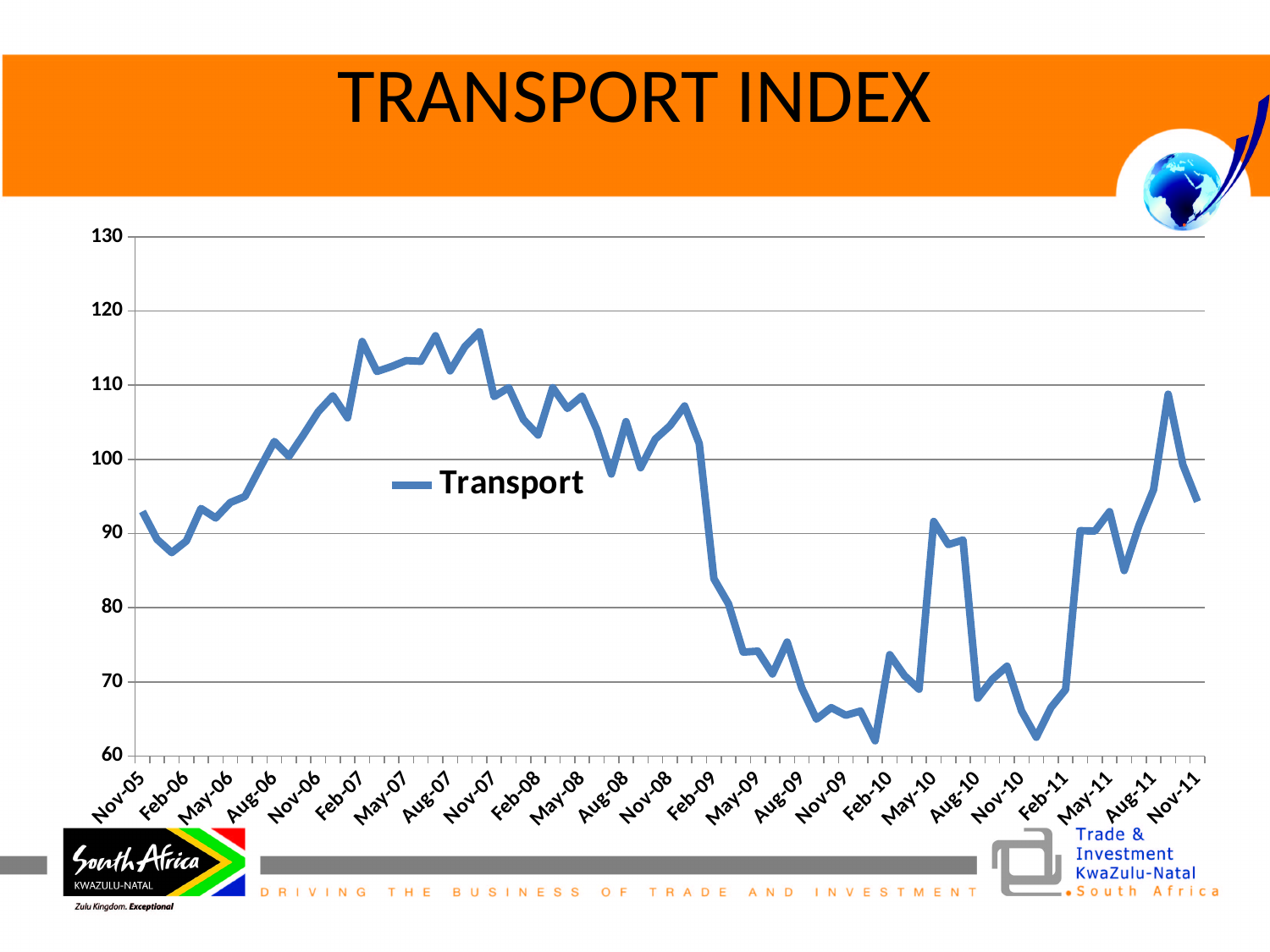
Does the Transport index generally rise or fall between Feb-09 and Feb-10? fall Does the Transport index generally rise or fall between Nov-05 and Nov-07? rise How many series does the legend list? 1 Is the value for Aug-11 greater or less than 100? less Is the value for Feb-06 greater or less than 90? less Is the value for Nov-07 greater or less than 110? less What kind of chart is shown on the slide? line chart What is the name of the series shown in the legend? Transport What is the title of the slide containing the chart? TRANSPORT INDEX